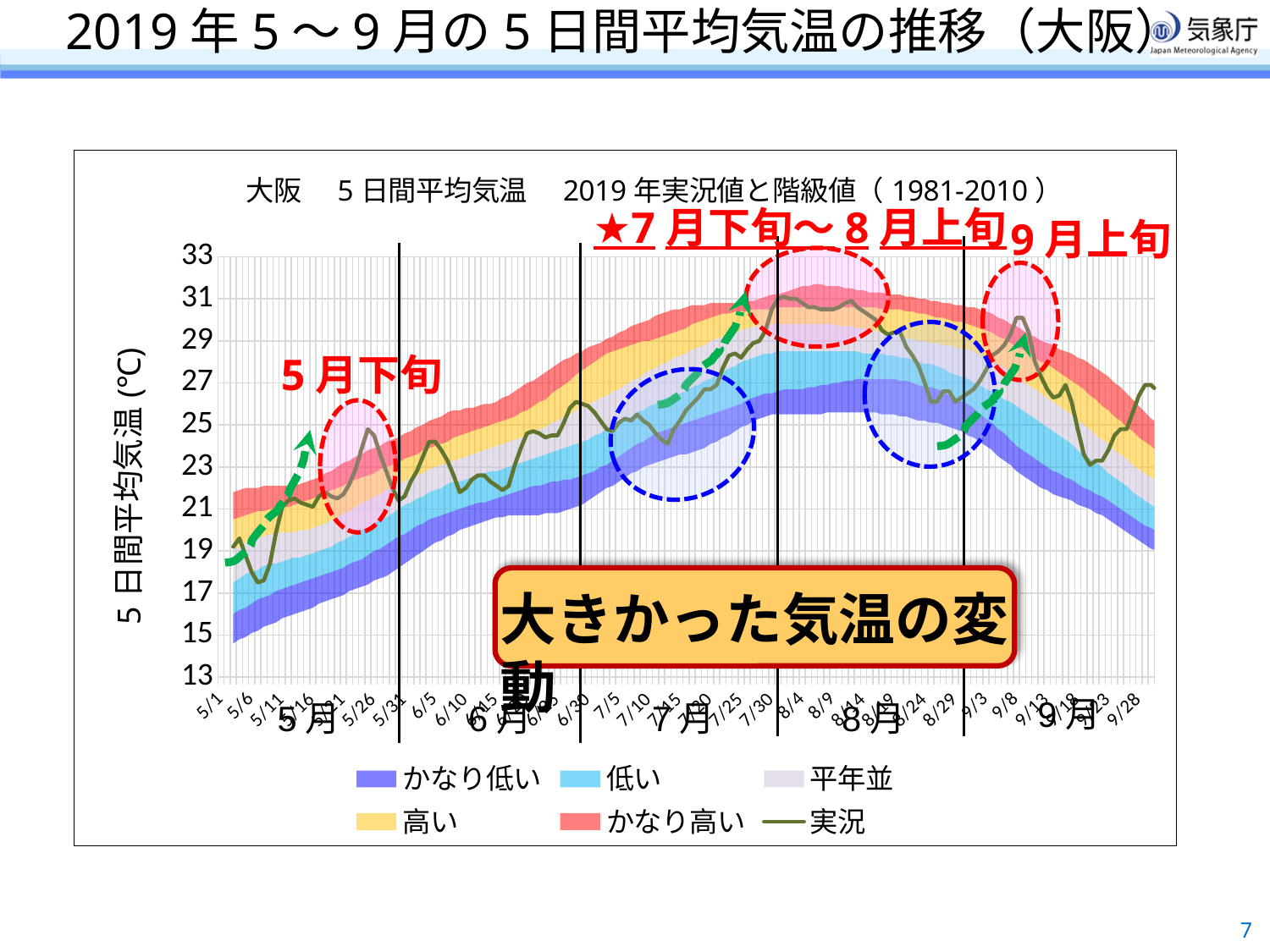
In which month does the 実況 line reach its highest point? 8月 Is the 実況 value around 7/15 greater or less than 27? less What is the lowest value shown on the vertical axis? 13 What is the highest value shown on the vertical axis? 33 Does the 実況 line generally rise or fall from 5/1 to 7/30? rise Is the 実況 value around 8/4 greater or less than 29? greater In which month does the 実況 line reach its lowest point? 5月 What is the label of the vertical axis? 5日間平均気温 (℃) What kind of chart is shown on the slide? line chart with shaded bands (area chart) How many entries does the chart legend list? 6 What is the title printed inside the chart area? 大阪 5日間平均気温 2019年実況値と階級値（1981-2010）